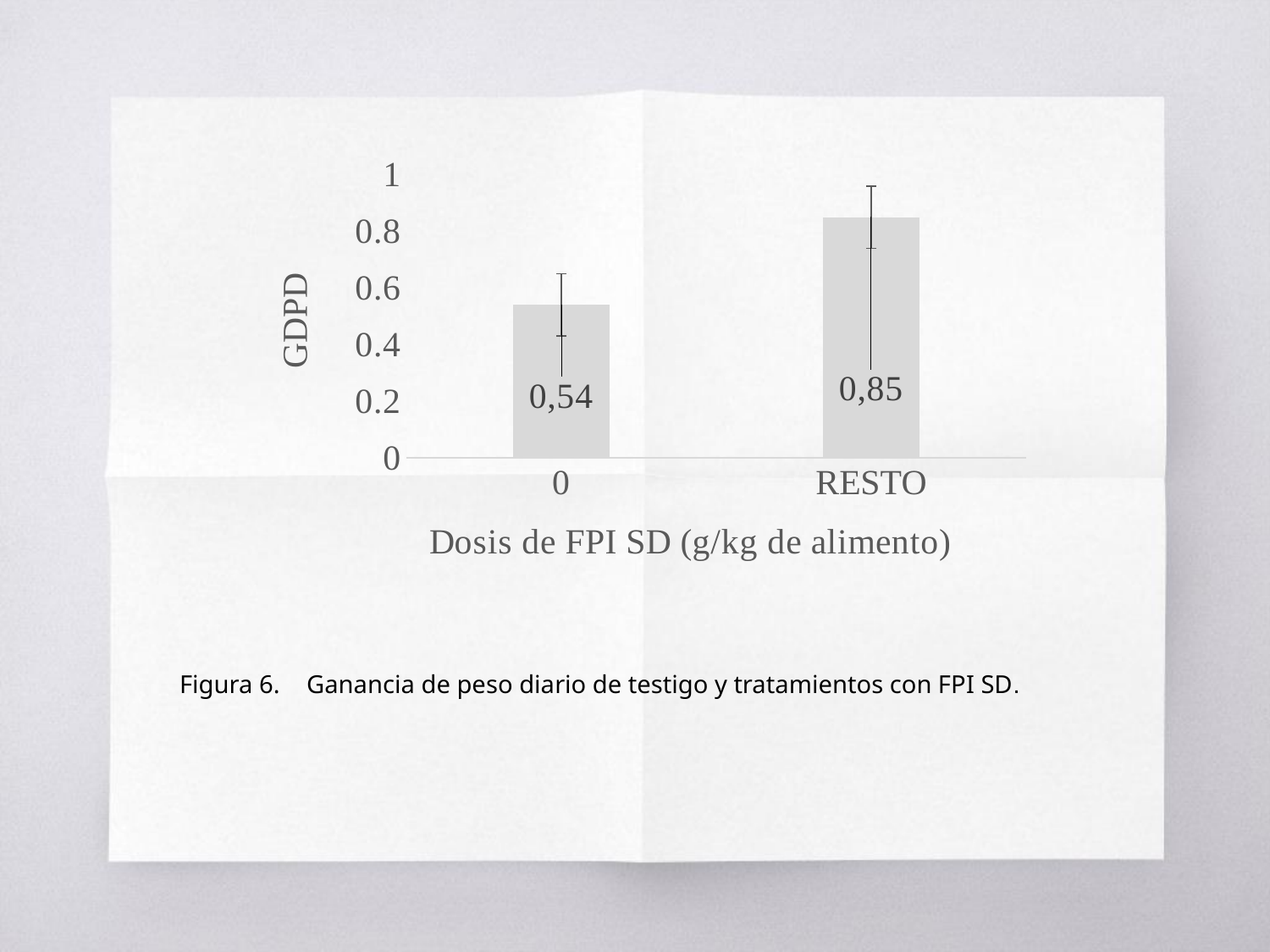
What is the GDPD value for RESTO? 0,85 What is the GDPD value for the category 0? 0,54 Which category has the lowest GDPD value? 0 What is the label of the y axis? GDPD How many categories are shown on the x axis? 2 Which category has the highest GDPD value? RESTO Is the GDPD value for RESTO greater or less than 0.6? greater Which is larger, the GDPD value for 0 or for RESTO? RESTO What kind of chart is shown on the slide? bar chart Is the GDPD value for 0 greater or less than 0.8? less What is the difference between the GDPD values for RESTO and 0? 0,31 What is the label of the x axis? Dosis de FPI SD (g/kg de alimento)